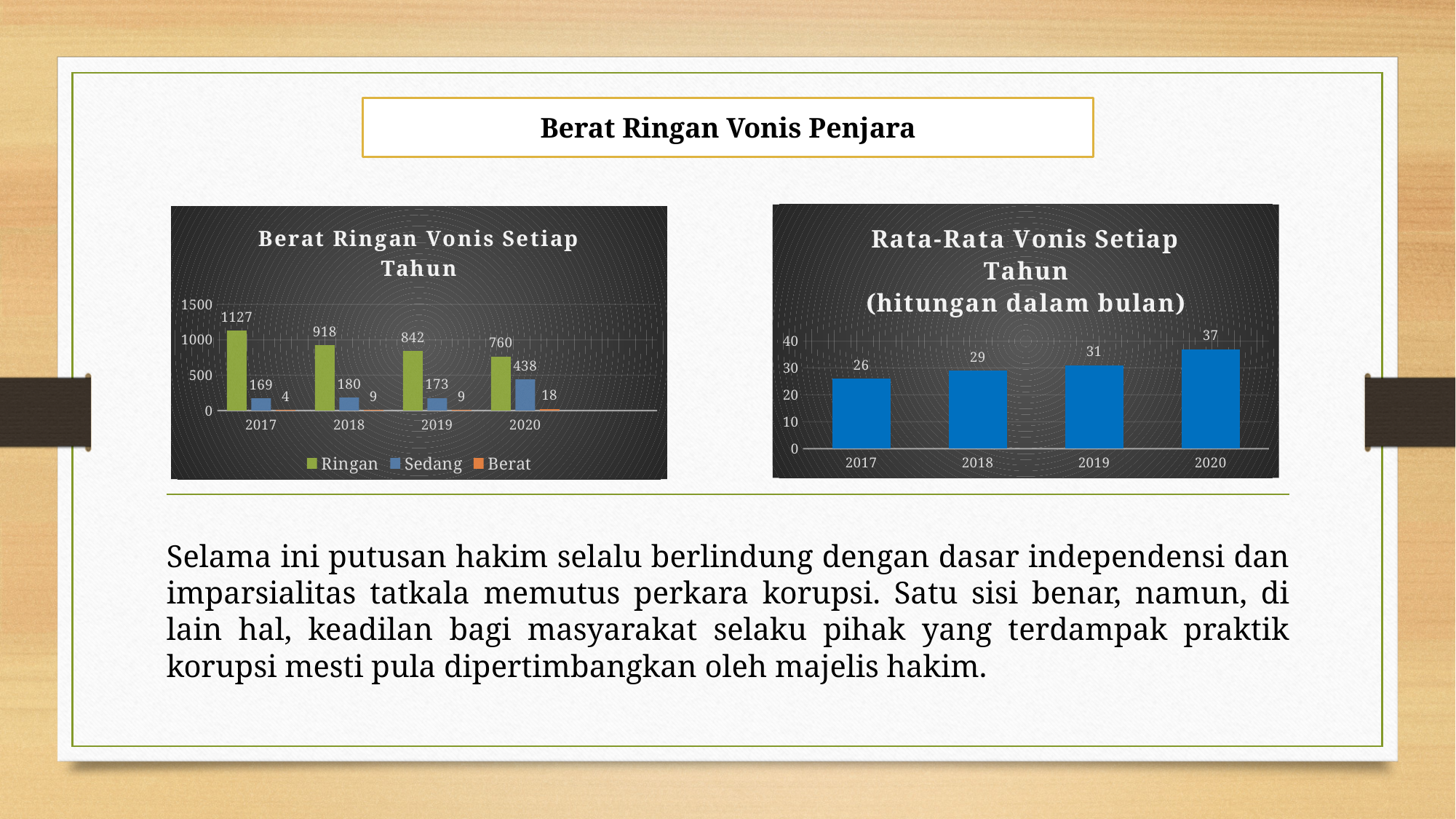
In the 'Berat Ringan Vonis Setiap Tahun' chart, how many series does the legend list? 3 In the 'Berat Ringan Vonis Setiap Tahun' chart, what is the value for Ringan in 2017? 1127 In the 'Rata-Rata Vonis Setiap Tahun' chart, which year has the highest value? 2020 In the 'Berat Ringan Vonis Setiap Tahun' chart, which year has the lowest Berat value? 2017 In the 'Berat Ringan Vonis Setiap Tahun' chart, what is the value for Berat in 2018? 9 What kind of chart is the 'Rata-Rata Vonis Setiap Tahun' chart? bar chart In the 'Berat Ringan Vonis Setiap Tahun' chart, what is the difference between the Ringan values for 2017 and 2020? 367 In the 'Berat Ringan Vonis Setiap Tahun' chart, does the Ringan value rise or fall from 2017 to 2020? fall In the 'Berat Ringan Vonis Setiap Tahun' chart, what is the value for Sedang in 2020? 438 In the 'Rata-Rata Vonis Setiap Tahun' chart, what is the value for 2019? 31 In the 'Rata-Rata Vonis Setiap Tahun' chart, what is the difference between the values for 2020 and 2017? 11 In the 'Berat Ringan Vonis Setiap Tahun' chart, which year has the highest Ringan value? 2017